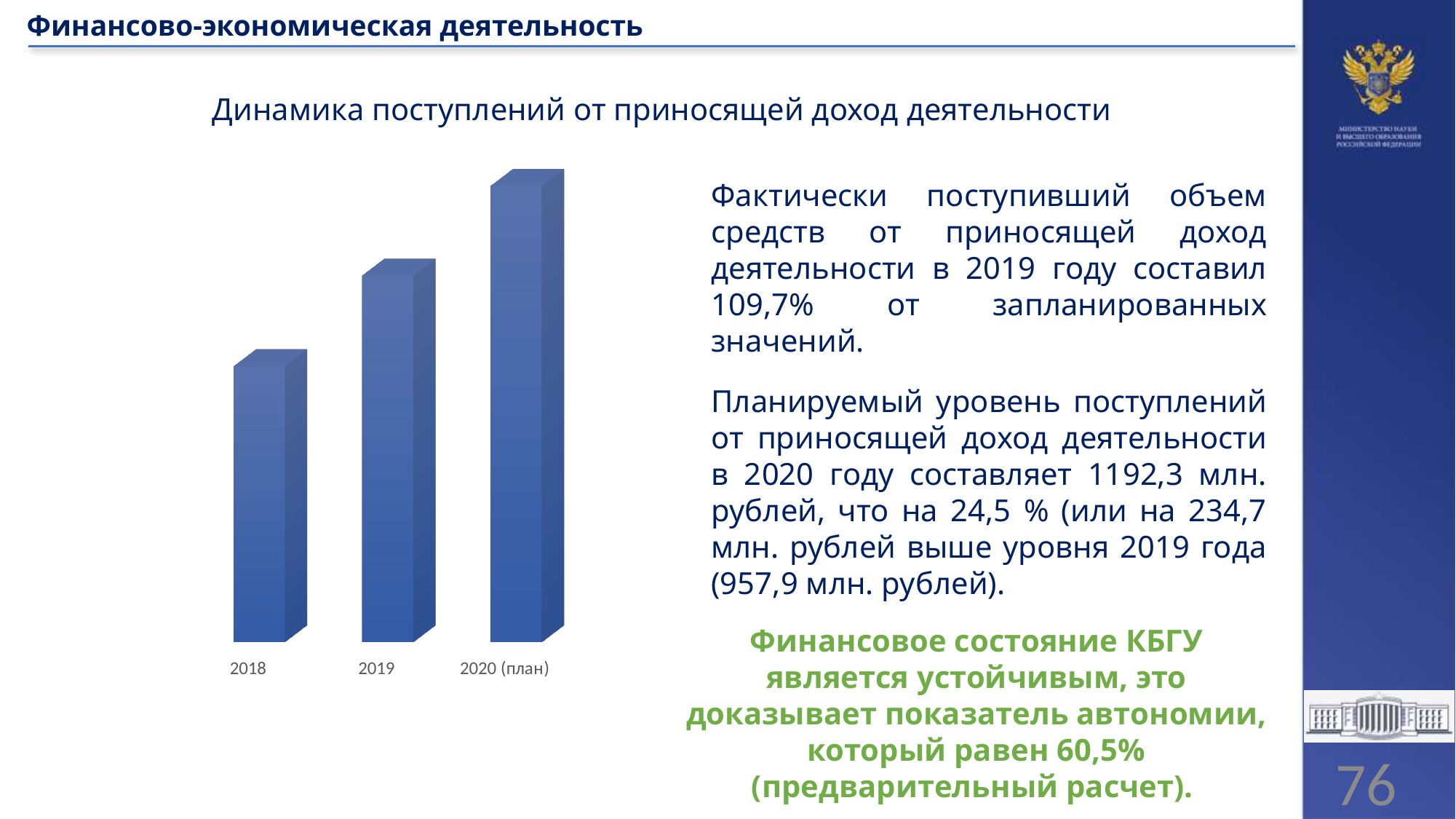
Which category has the highest bar in the chart? 2020 (план) Which bar is taller, 2019 or 2020 (план)? 2020 (план) What is the label of the last category on the x axis? 2020 (план) What kind of chart is shown on the slide? bar chart What colour are the bars in the chart? blue What is the label of the first category on the x axis? 2018 How many bars (categories) does the chart show? 3 Do the bar values rise or fall from 2018 to 2020 (план)? rise What is the title of the chart? Динамика поступлений от приносящей доход деятельности Which category has the lowest bar in the chart? 2018 Which bar is taller, 2018 or 2019? 2019